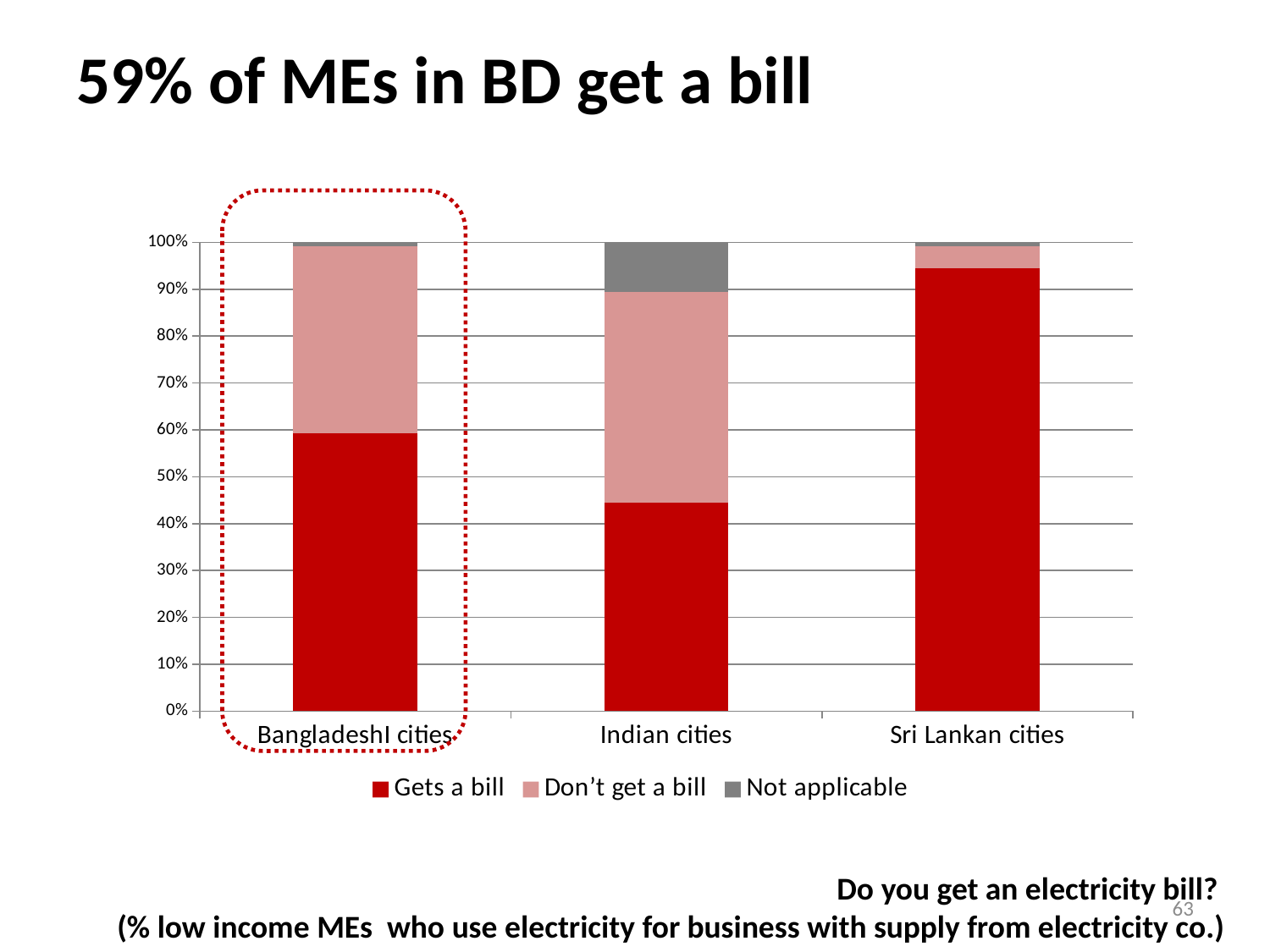
Which is larger, the 'Gets a bill' share for Bangladeshi cities or for Indian cities? Bangladeshi cities Which category is highlighted with a red dotted outline on the chart? Bangladeshi cities How many series does the legend list? 3 How many categories (city groups) are shown on the x axis? 3 What kind of chart is shown on the slide? bar chart What is the total of the stacked bar for Indian cities? 100% Which category has the lowest share for 'Gets a bill'? Indian cities Is the 'Gets a bill' share for Indian cities greater or less than 50%? less Is the 'Gets a bill' share for Sri Lankan cities greater or less than 90%? greater Which category has the highest share for 'Gets a bill'? Sri Lankan cities What percentage of MEs in Bangladeshi cities get a bill, according to the slide? 59% Which category has the largest 'Not applicable' segment? Indian cities